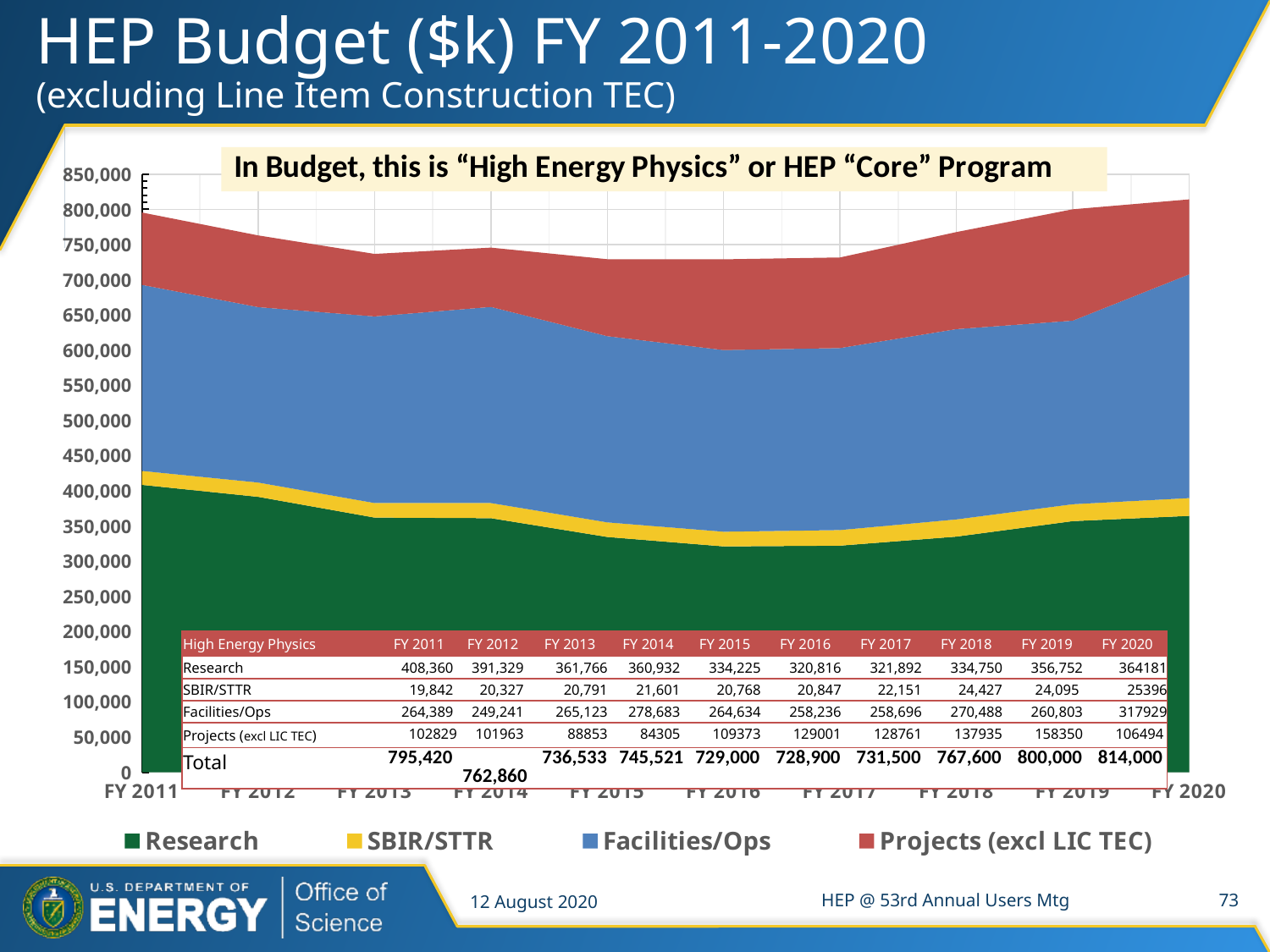
In which fiscal year is the Total highest? FY 2020 What is the Research value for FY 2011? 408,360 How many series does the legend list? 4 What is the Total for FY 2019? 800,000 In which fiscal year is the Projects (excl LIC TEC) value lowest? FY 2014 What is the difference between the Total for FY 2020 and the Total for FY 2011? 18,580 Which is larger in FY 2011, Research or Facilities/Ops? Research How many fiscal years are plotted along the x axis? 10 What is the title of the chart? HEP Budget ($k) FY 2011-2020 (excluding Line Item Construction TEC) What is the Facilities/Ops value for FY 2020? 317929 Does the Total rise or fall from FY 2016 to FY 2020? Rise What kind of chart is shown on the slide? Stacked area chart